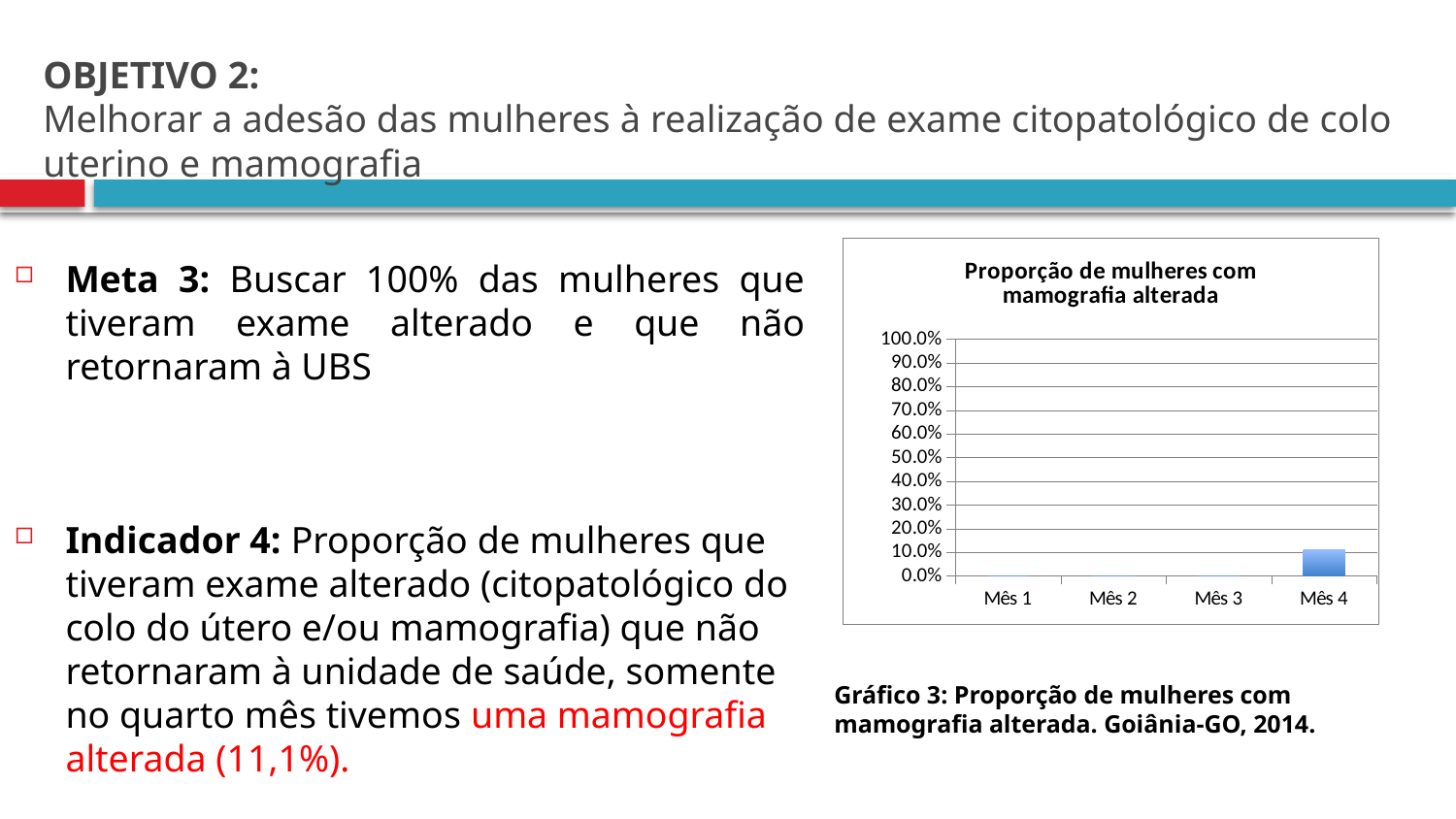
Is the value for Mês 4 greater or less than 20.0%? less What is the title of the chart on the slide? Proporção de mulheres com mamografia alterada Which category has the highest value in the chart? Mês 4 Is the value for Mês 4 greater or less than 50.0%? less What is the value for Mês 2 in the chart? 0.0% Which is larger, the value for Mês 3 or the value for Mês 4? Mês 4 What is the value for Mês 1 in the chart? 0.0% What kind of chart is shown on the slide? bar chart How many categories are shown on the x axis of the chart? 4 What is the value for Mês 3 in the chart? 0.0% Do the values in the chart rise or fall from Mês 3 to Mês 4? rise What is the highest value shown on the y axis of the chart? 100.0%